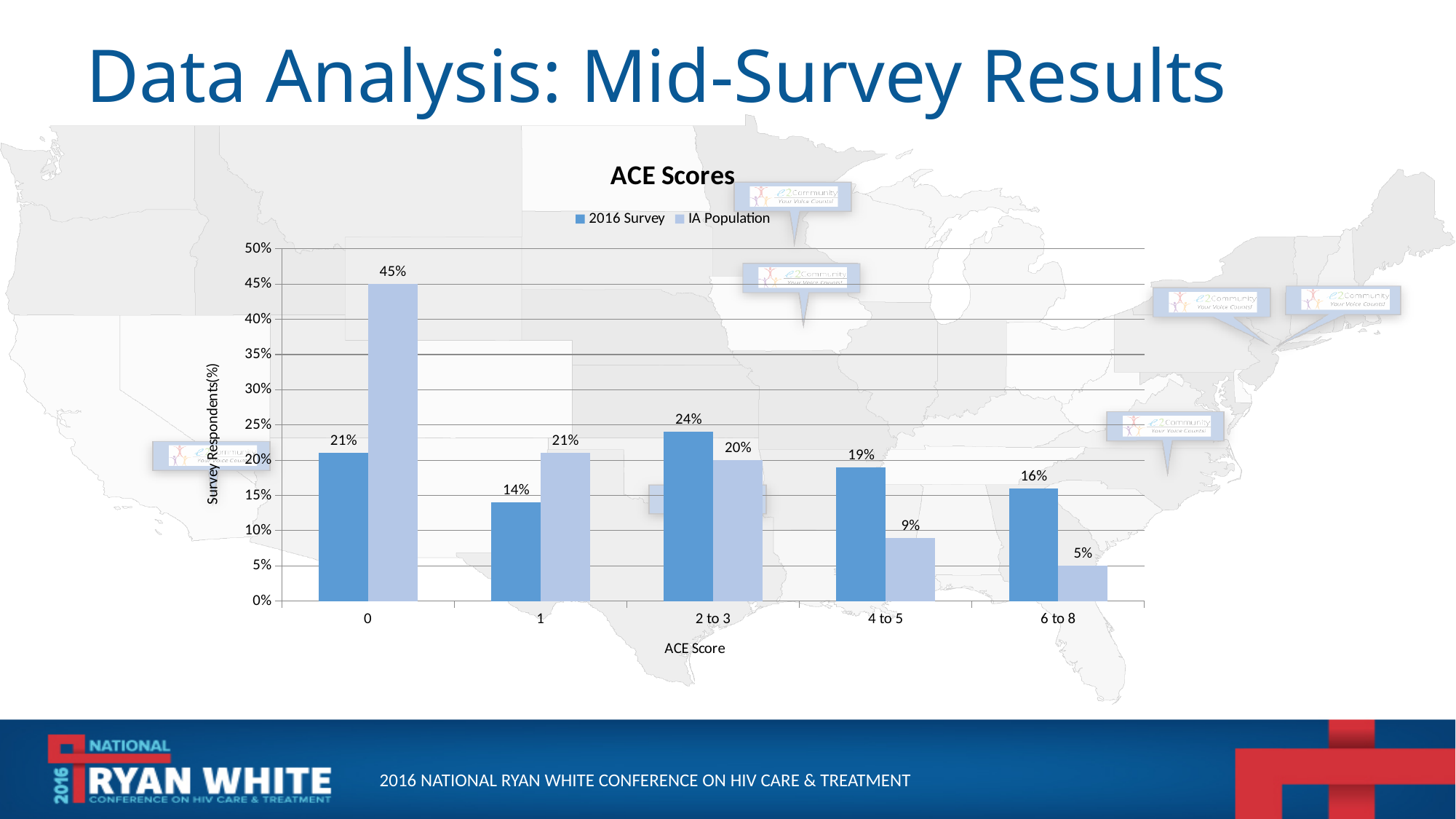
What is the difference between the IA Population and 2016 Survey values for an ACE Score of 0? 24% What kind of chart is shown on the slide? Bar chart How many ACE Score categories are shown on the x axis? 5 Which ACE Score category has the highest IA Population value? 0 What is the 2016 Survey value for an ACE Score of 2 to 3? 24% How many series does the legend list? 2 What is the IA Population value for an ACE Score of 0? 45% What is the IA Population value for an ACE Score of 6 to 8? 5% What is the 2016 Survey value for an ACE Score of 0? 21% Which ACE Score category has the lowest 2016 Survey value? 1 What is the title of the chart? ACE Scores For an ACE Score of 4 to 5, which is larger: the 2016 Survey value or the IA Population value? 2016 Survey